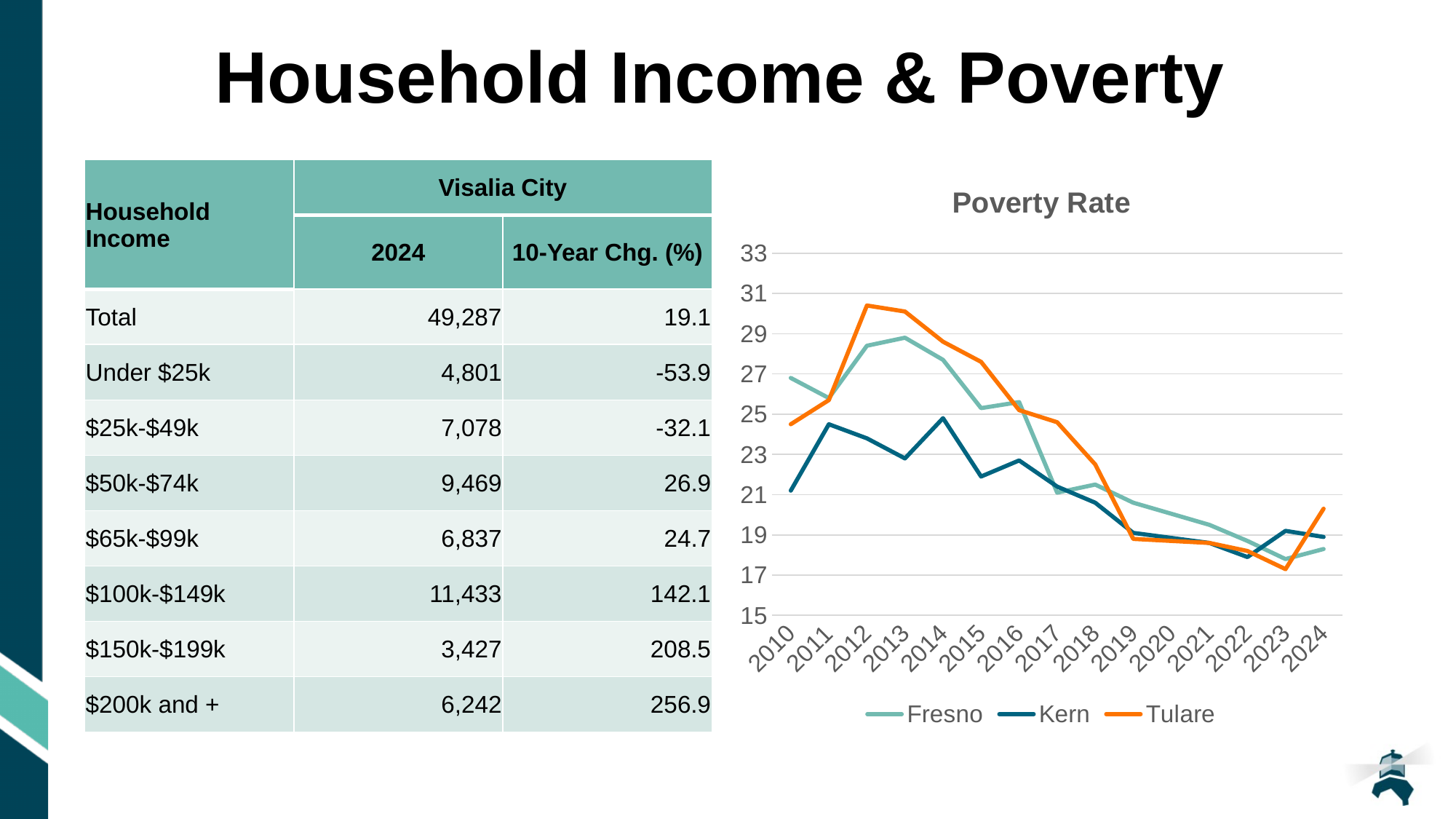
How many series does the legend of the Poverty Rate chart list? 3 In the Poverty Rate chart, is the value for Fresno in 2017 greater or less than 23? less What kind of chart is the Poverty Rate chart? line chart In the Poverty Rate chart, is the value for Tulare in 2012 greater or less than 29? greater In the Poverty Rate chart, which is higher in 2024, Tulare or Fresno? Tulare In the Poverty Rate chart, which county has the highest poverty rate in 2013? Tulare In the Poverty Rate chart, which county has the lowest poverty rate in 2010? Kern In the Poverty Rate chart, does the Fresno line rise or fall from 2013 to 2023? fall What is the title of the line chart on the slide? Poverty Rate In the Poverty Rate chart, which is higher in 2012, Tulare or Fresno? Tulare How many years are shown on the x axis of the Poverty Rate chart? 15 In the Poverty Rate chart, is the value for Kern in 2010 greater or less than 23? less